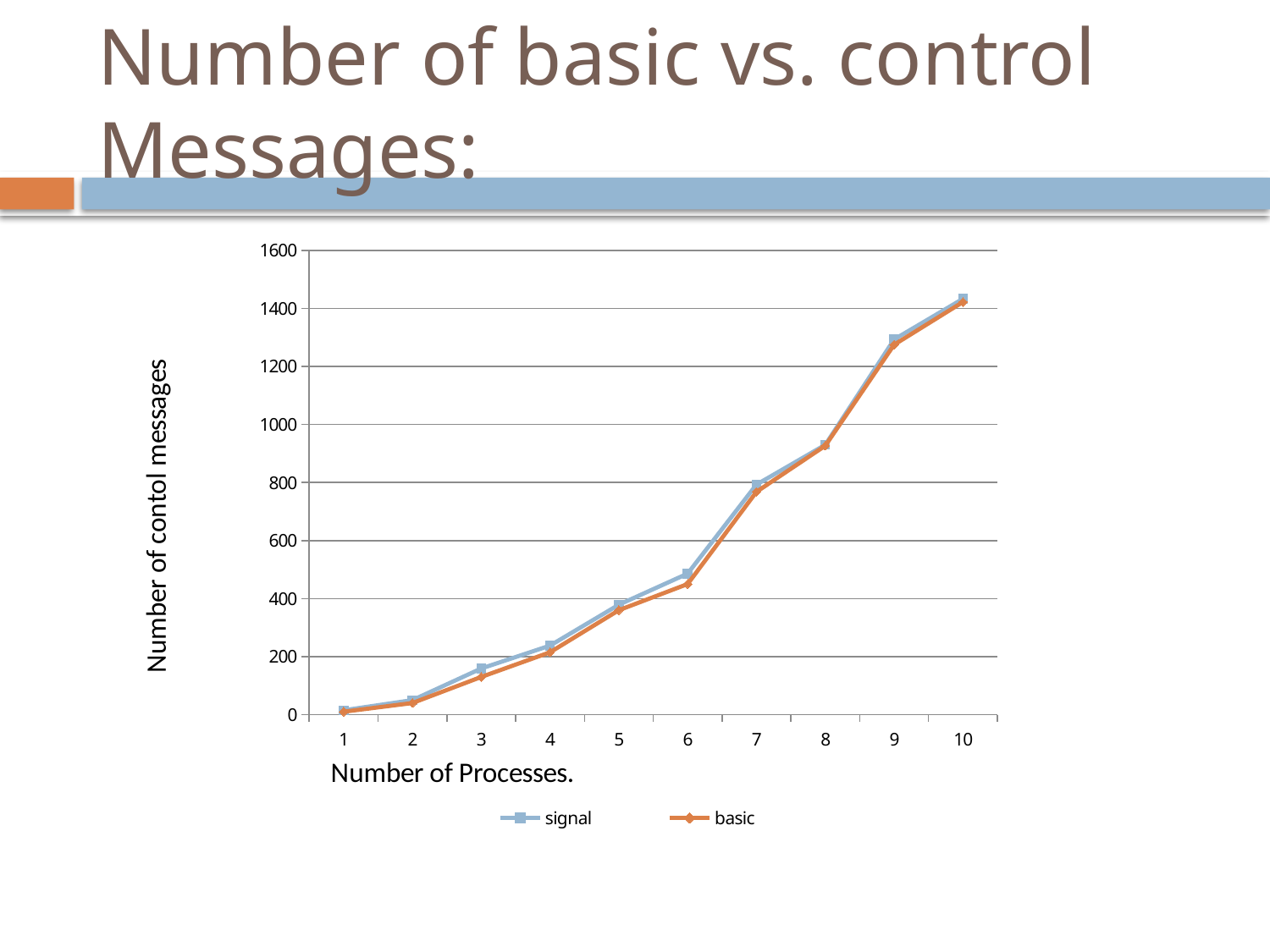
What is the label of the y axis? Number of contol messages Is the value for the signal series at 9 processes greater or less than 1200? greater At which number of processes is the basic series lowest? 1 Do the values for the signal series rise or fall as the number of processes increases? rise Is the value for the signal series at 8 processes greater or less than 1000? less Is the value for the basic series at 3 processes greater or less than 200? less How many points along the x axis (Number of Processes) are plotted for each series? 10 At 6 processes, which series has the larger value, signal or basic? signal How many series does the legend list? 2 What kind of chart is shown on the slide? line chart At which number of processes is the signal series highest? 10